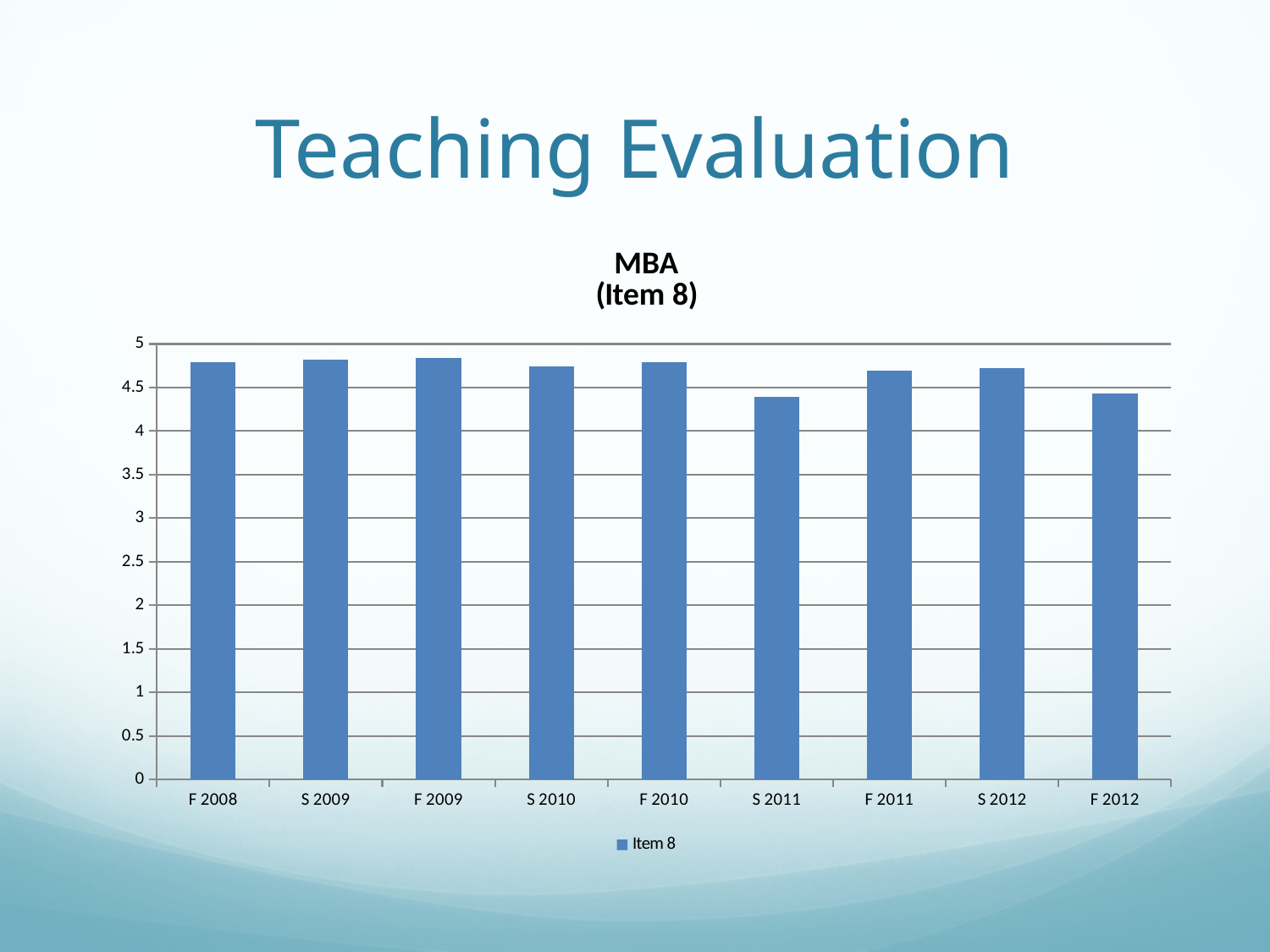
Which has the larger value, F 2008 or F 2012? F 2008 Is the value for F 2008 greater or less than 4? greater What is the title of the chart? MBA (Item 8) Is the value for F 2012 greater or less than 4.5? less Is the value for S 2011 greater or less than 4.5? less What series name appears in the chart's legend? Item 8 Which has the larger value, F 2009 or S 2011? F 2009 How many series does the chart's legend list? 1 How many categories (semesters) are shown on the x axis of the chart? 9 Which semester has the lowest value in the chart? S 2011 What kind of chart is shown on the slide? bar chart